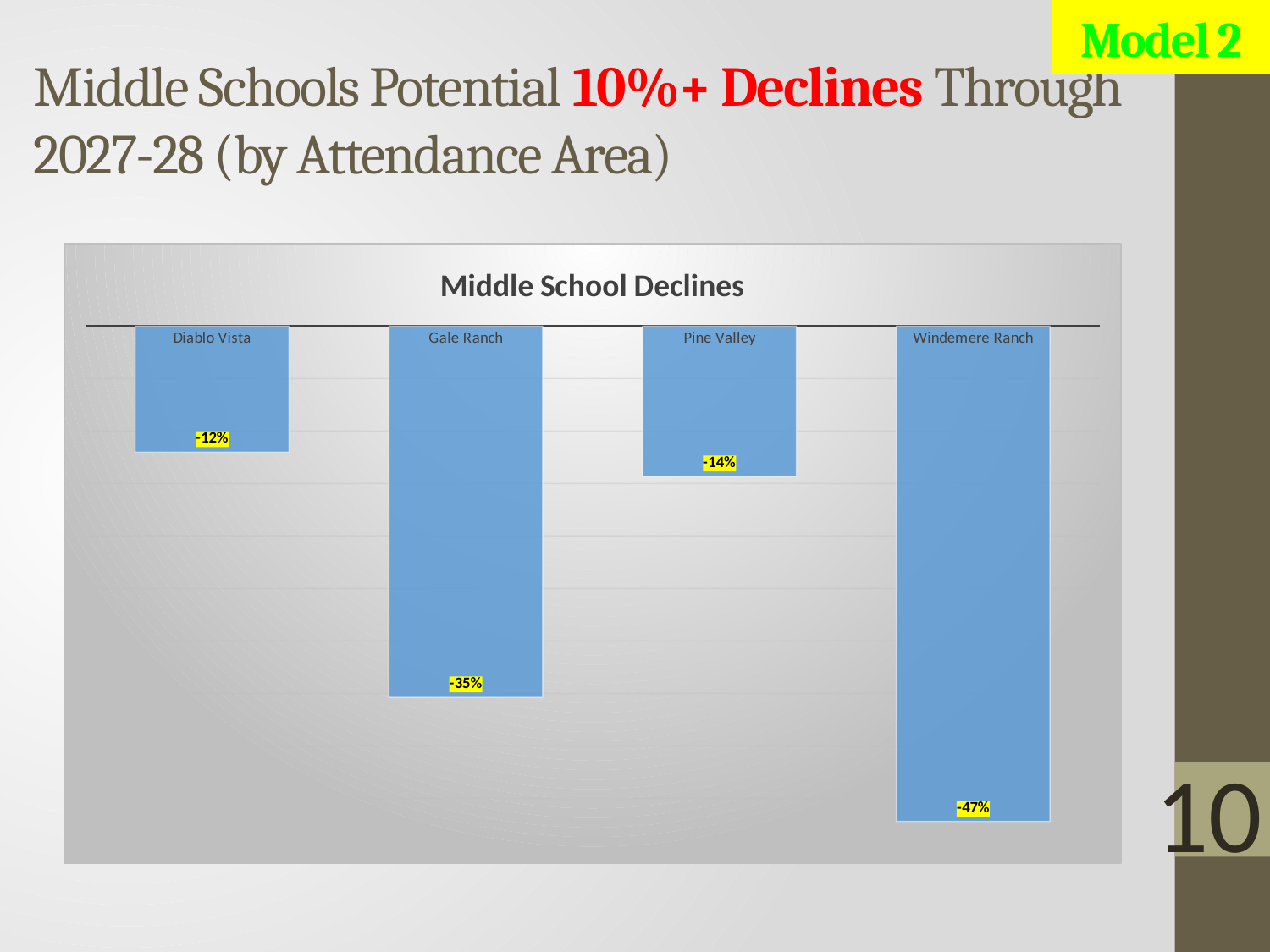
How many attendance areas are shown in the chart? 4 What is the value shown for Pine Valley? -14% What is the value shown for Diablo Vista in the Middle School Declines chart? -12% By how many percentage points does the decline for Gale Ranch exceed the decline for Diablo Vista? 23 percentage points What kind of chart is shown on the slide? Bar chart By how many percentage points does the decline for Windemere Ranch exceed the decline for Gale Ranch? 12 percentage points What is the value shown for Windemere Ranch? -47% What is the value shown for Gale Ranch? -35% Which has the larger decline, Pine Valley or Gale Ranch? Gale Ranch What is the title of the chart? Middle School Declines Which attendance area shows the smallest decline? Diablo Vista Which attendance area shows the largest decline? Windemere Ranch